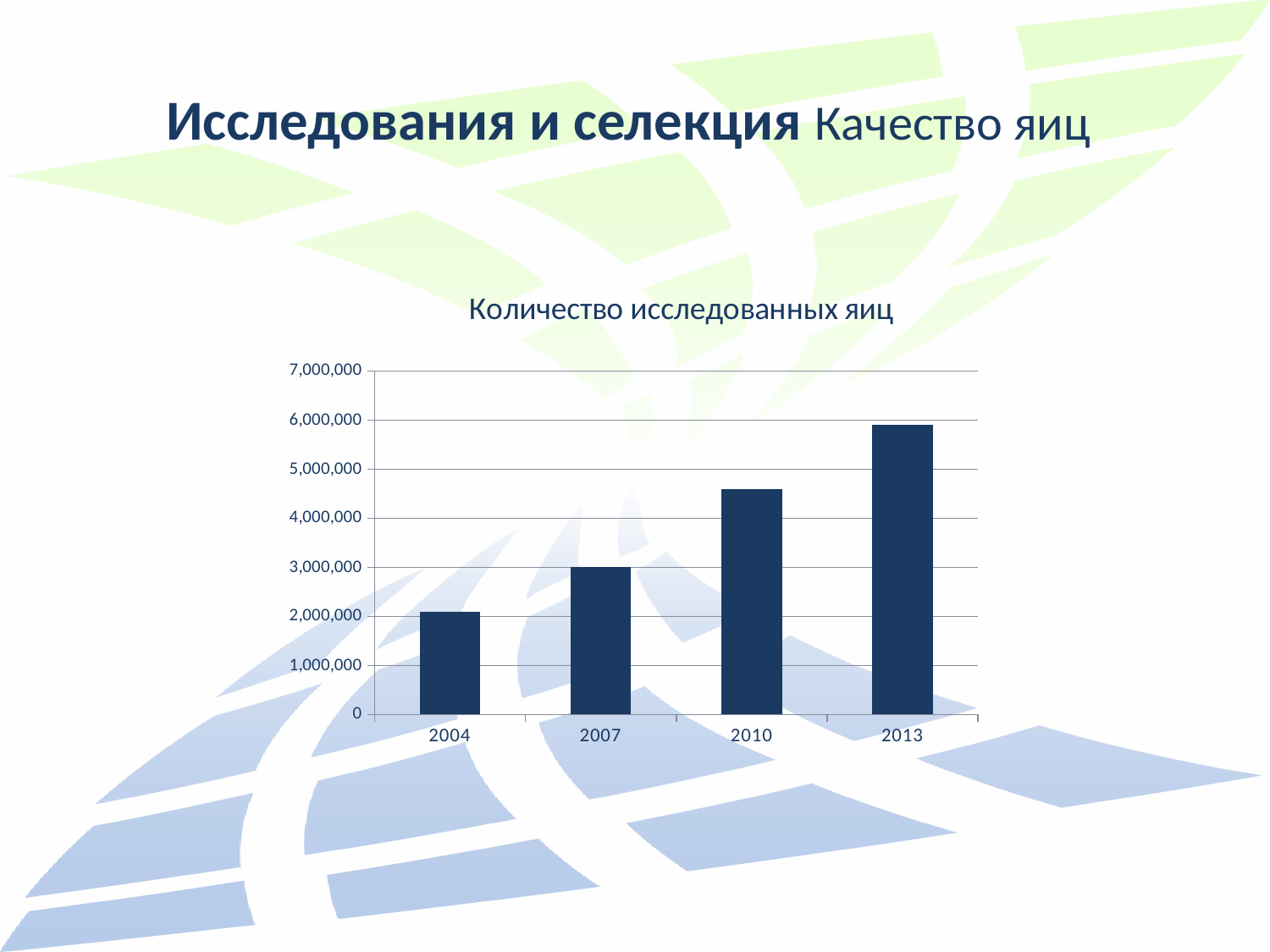
Is the value for 2007 greater or less than 4,000,000? less Is the value for 2010 greater or less than 5,000,000? less Is the value for 2010 greater or less than 4,000,000? greater Which year has the lowest number of examined eggs? 2004 Which year has the highest number of examined eggs? 2013 Which year has the larger value, 2007 or 2010? 2010 Do the values rise or fall from 2004 to 2013? rise What is the title of the chart? Количество исследованных яиц What kind of chart is shown on the slide? bar chart How many years are shown on the x axis of the chart? 4